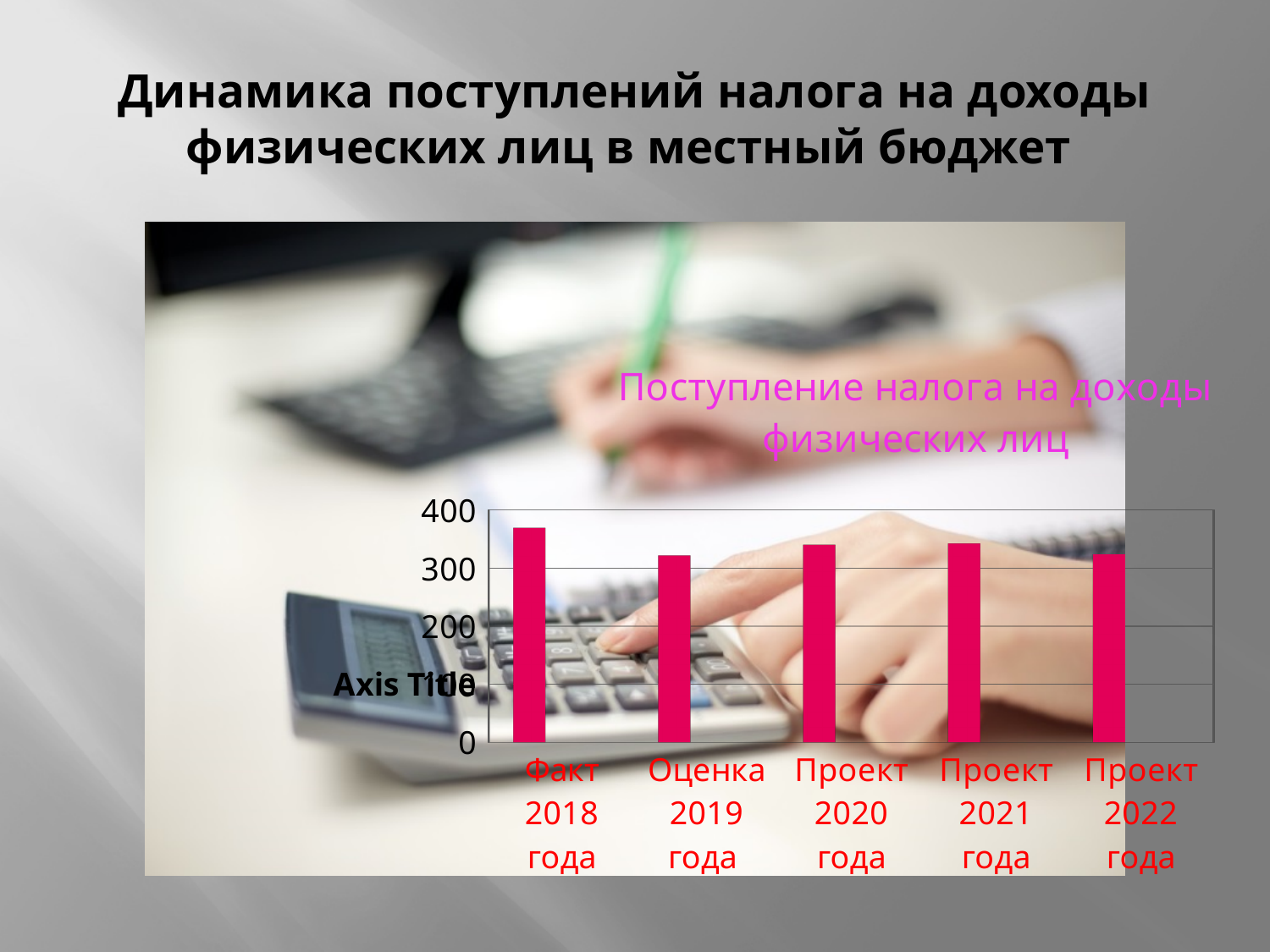
What is the highest value shown on the vertical axis of the chart? 400 Is the value for Факт 2018 года greater or less than 400? less How many categories are shown on the x axis of the chart? 5 What is the title of the chart? Поступление налога на доходы физических лиц Is the value for Проект 2020 года greater or less than 200? greater Which is larger, the value for Факт 2018 года or the value for Проект 2022 года? Факт 2018 года Which category has the highest bar in the chart? Факт 2018 года Is the value for Оценка 2019 года greater or less than 300? greater Which is larger, the value for Факт 2018 года or the value for Оценка 2019 года? Факт 2018 года What kind of chart is shown on the slide? bar chart